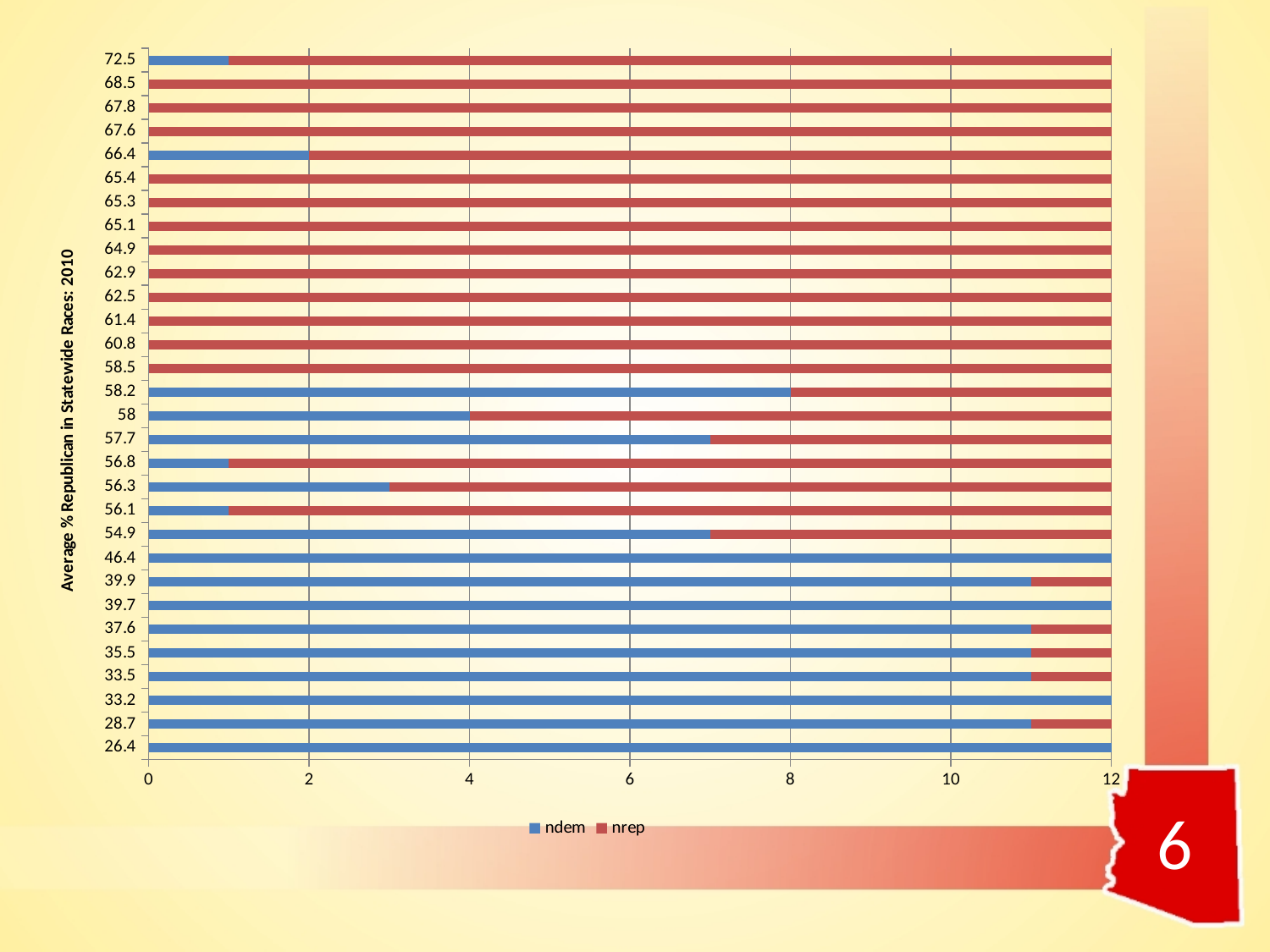
How many series does the legend list? 2 What is the total of the stacked bar for the 68.5 category? 12 How many categories are plotted on the y axis? 30 What is the y-axis title of the chart? Average % Republican in Statewide Races: 2010 What kind of chart is shown on the slide? bar chart Is the ndem value for the 57.7 category greater or less than 6? greater Is the nrep value for the 39.9 category greater or less than 2? less What are the names of the two series in the legend? ndem and nrep What is the ndem value for the 66.4 category? 2 Which has the larger ndem value, the 58.2 category or the 58 category? 58.2 What is the ndem value for the 58 category? 4 What is the ndem value for the 58.2 category? 8